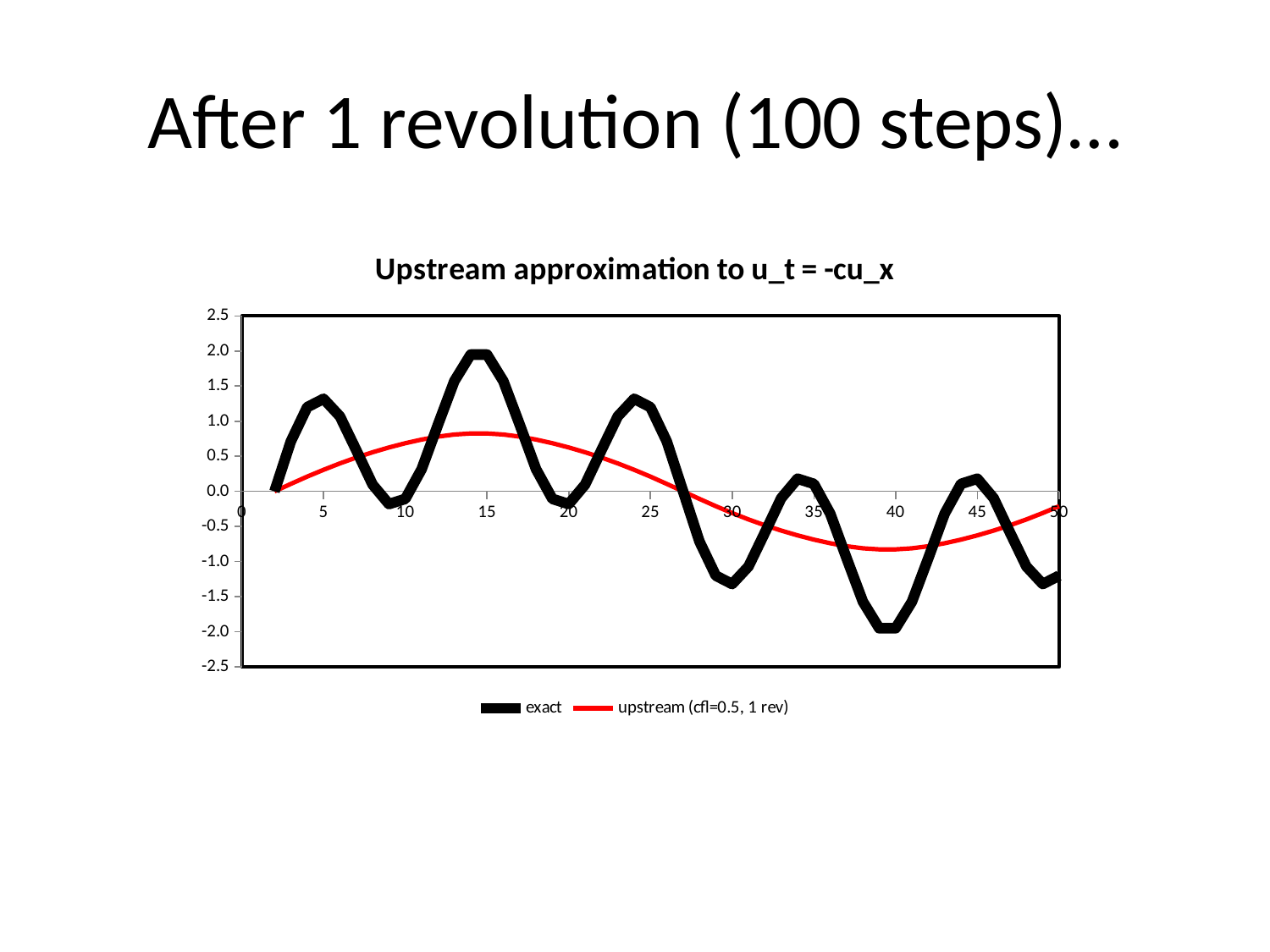
What kind of chart is shown on the slide? line chart What is the title of the chart? Upstream approximation to u_t = -cu_x Which series reaches the highest peak on the chart? exact How many series does the legend list? 2 Is the value of the exact series at x = 15 greater or less than 1.5? greater Does the upstream (cfl=0.5, 1 rev) curve rise or fall between x = 15 and x = 40? fall Is the value of the upstream (cfl=0.5, 1 rev) series at x = 15 greater or less than 1.0? less At x = 40, which series has the higher value, exact or upstream (cfl=0.5, 1 rev)? upstream (cfl=0.5, 1 rev) Which series is drawn in red? upstream (cfl=0.5, 1 rev) Is the value of the upstream (cfl=0.5, 1 rev) series at x = 40 greater or less than -1.0? greater At x = 15, which series has the higher value, exact or upstream (cfl=0.5, 1 rev)? exact